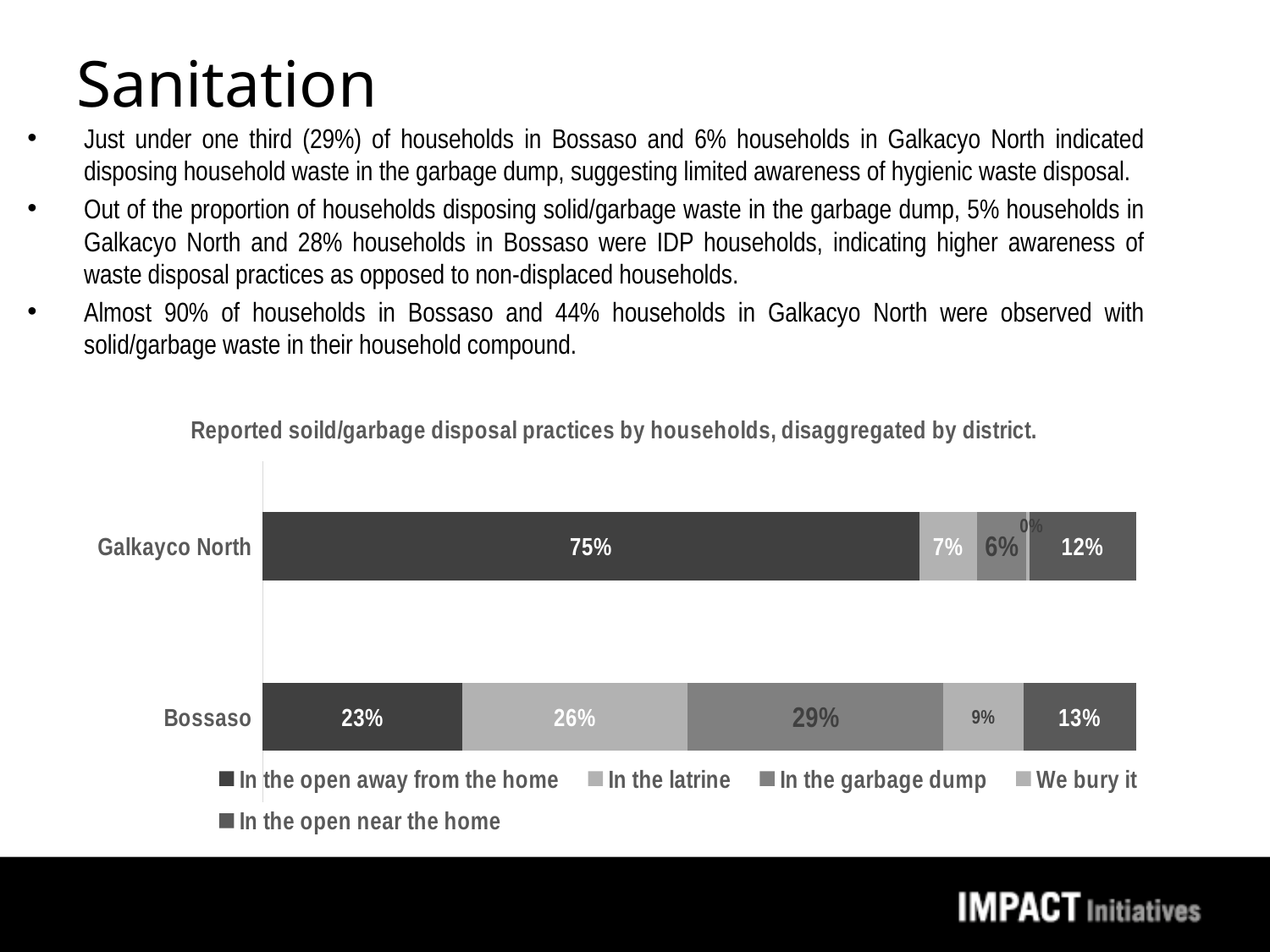
Which disposal practice has the largest share in Bossaso? In the garbage dump What is the difference between the 'In the garbage dump' shares for Bossaso and Galkayco North? 23% What percentage of households in Galkayco North reported burying their waste? 0% What is the total of the stacked bar for Bossaso? 100% What percentage of households in Bossaso reported disposing waste in the latrine? 26% How many districts (categories) are shown in the chart? 2 What percentage of households in Bossaso reported disposing waste in the garbage dump? 29% What type of chart is shown on the slide? Stacked bar chart Which district has the higher share of households disposing waste in the open away from the home? Galkayco North What is the title of the chart? Reported soild/garbage disposal practices by households, disaggregated by district. What percentage of households in Galkayco North reported disposing waste in the open away from the home? 75% How many series does the legend list? 5